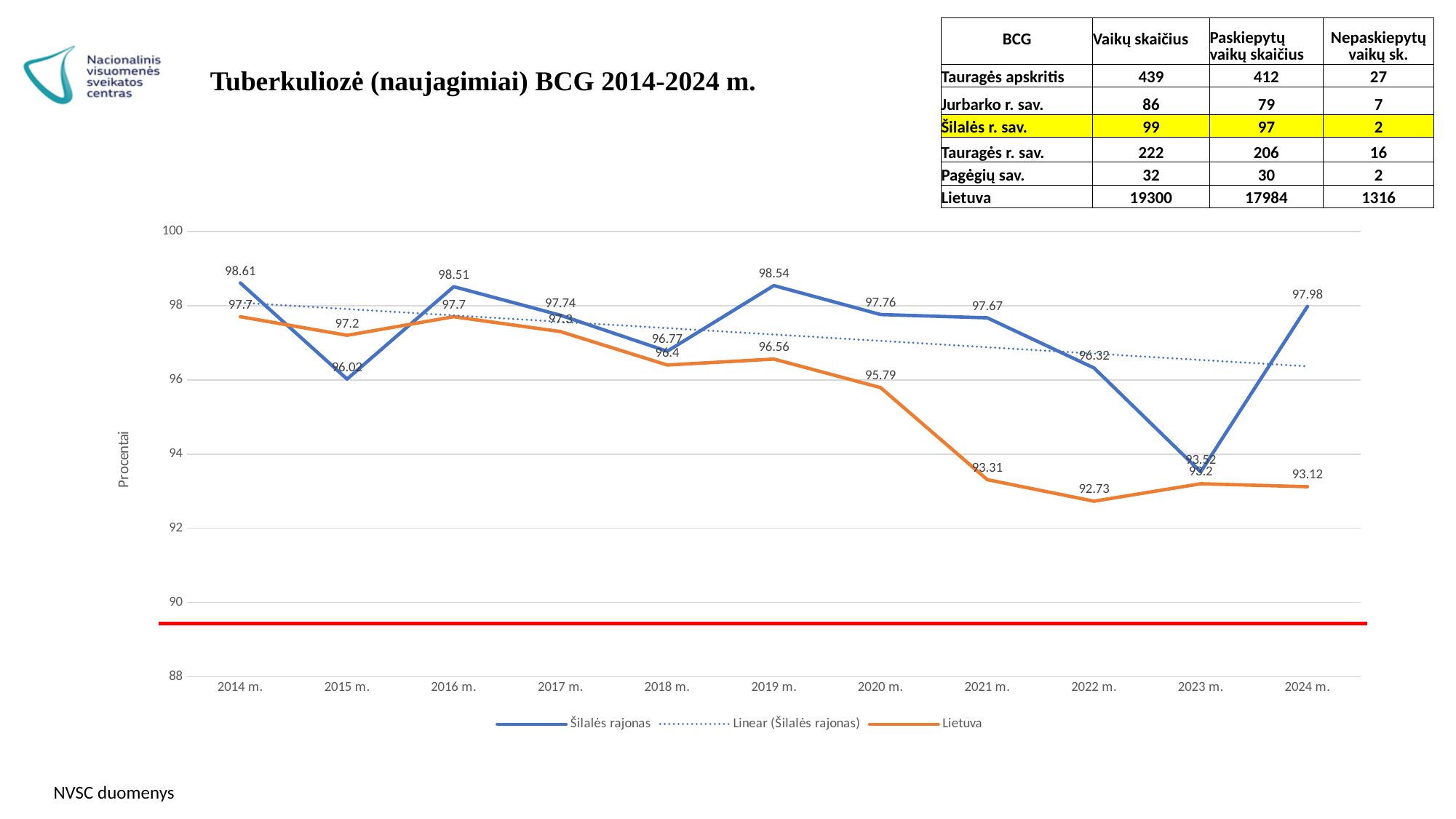
How many years are shown on the x axis of the chart? 11 In which year is the Lietuva value lowest? 2022 m. Which is larger in 2021 m., the Šilalės rajonas value or the Lietuva value? Šilalės rajonas What is the value for Šilalės rajonas in 2019 m.? 98.54 What is the value for Šilalės rajonas in 2023 m.? 93.52 In which year is the Šilalės rajonas value lowest? 2023 m. Does the Lietuva line generally rise or fall from 2014 m. to 2024 m.? Fall In which year is the Šilalės rajonas value highest? 2014 m. What is the value for Lietuva in 2022 m.? 92.73 What is the difference between the Šilalės rajonas and Lietuva values in 2024 m.? 4.86 How many entries does the chart legend list? 3 What kind of chart is shown on the slide? Line chart